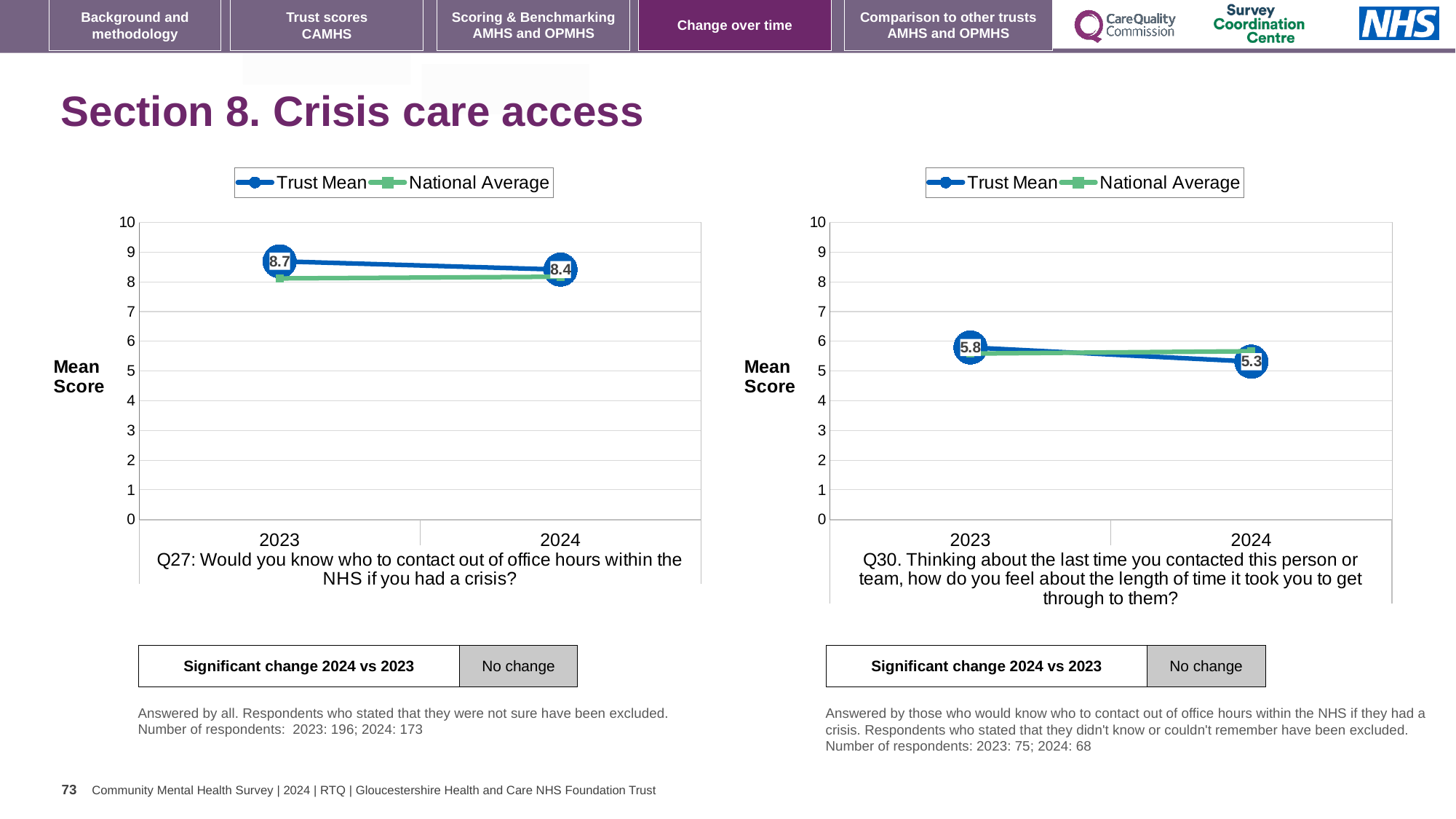
In the right chart (Q30), what is the difference between the Trust Mean in 2023 and 2024? 0.5 How many series does the legend of the right chart (Q30) list? 2 In the left chart (Q27), is the National Average for 2023 greater or less than 9? less In the right chart (Q30), does the Trust Mean rise or fall from 2023 to 2024? fall In the left chart (Q27), by how much did the Trust Mean change from 2023 to 2024? 0.3 How many years are shown on the x axis of the left chart (Q27)? 2 In the left chart (Q27), what is the Trust Mean score for 2023? 8.7 In the left chart (Q27), which is higher in 2023, the Trust Mean or the National Average? Trust Mean What type of chart is the left chart (Q27)? line chart In the right chart (Q30), what is the Trust Mean score for 2024? 5.3 In the right chart (Q30), what is the Trust Mean score for 2023? 5.8 In the left chart (Q27), what is the Trust Mean score for 2024? 8.4